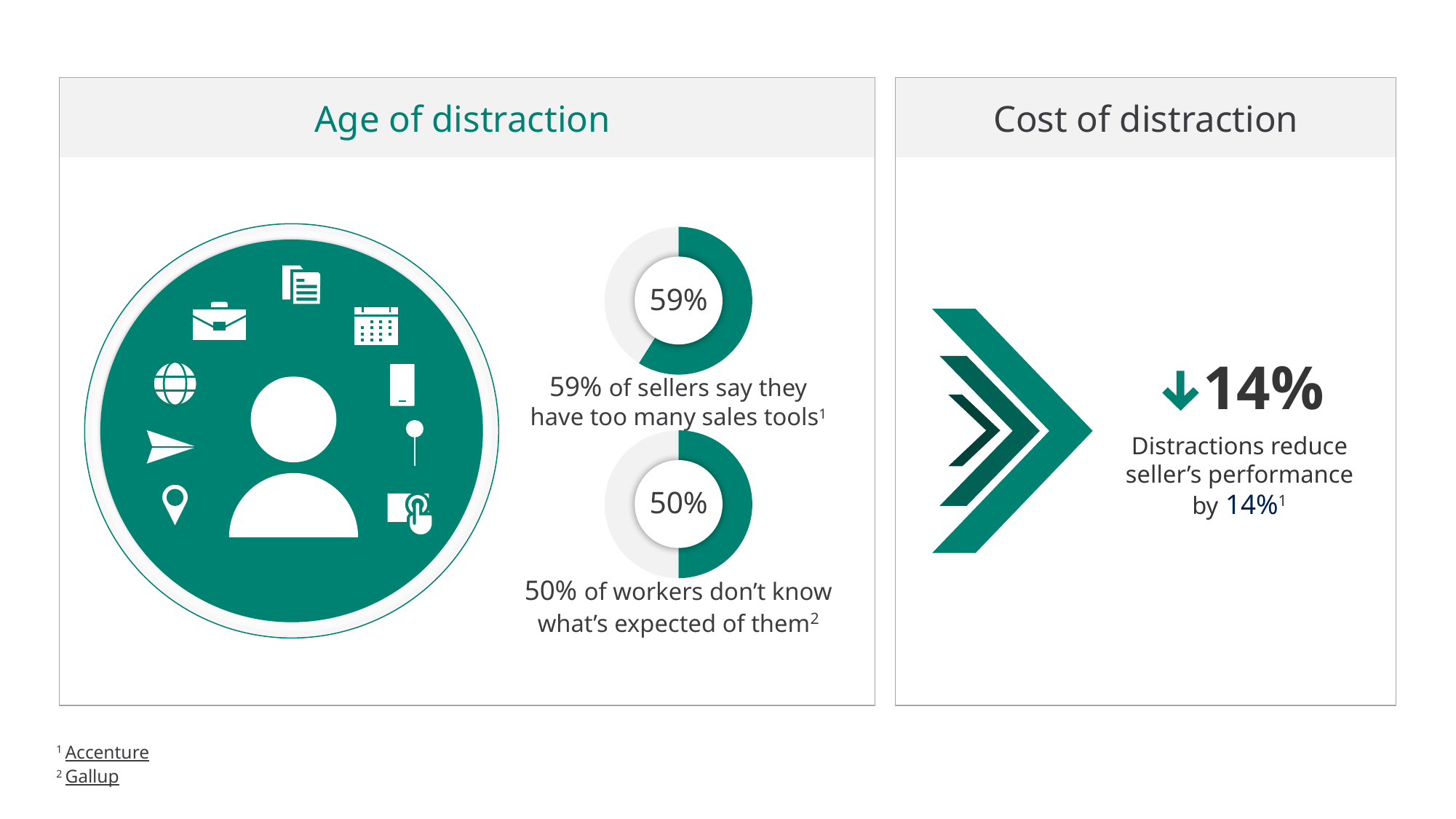
How many donut charts are shown in the 'Age of distraction' panel? 2 According to the bottom donut chart in the 'Age of distraction' panel, what percentage of workers don't know what's expected of them? 50% Which donut chart in the 'Age of distraction' panel shows the larger value, the top one or the bottom one? The top one In the 'Age of distraction' panel, what share of the bottom donut chart is filled in green? 50% In the 'Age of distraction' panel, what share of the top donut chart is filled in green? 59% In the 'Age of distraction' panel, what value does the bottom donut chart show? 50% What is the title of the panel that contains the two donut charts? Age of distraction What is the difference in percentage points between the top donut chart (59%) and the bottom donut chart (50%) in the 'Age of distraction' panel? 9 percentage points In the 'Age of distraction' panel, what value does the top donut chart show? 59% What colour is the filled portion of the donut charts in the 'Age of distraction' panel? Green What kind of chart is used to show the 59% and 50% figures in the 'Age of distraction' panel? Donut chart According to the top donut chart in the 'Age of distraction' panel, what percentage of sellers say they have too many sales tools? 59%